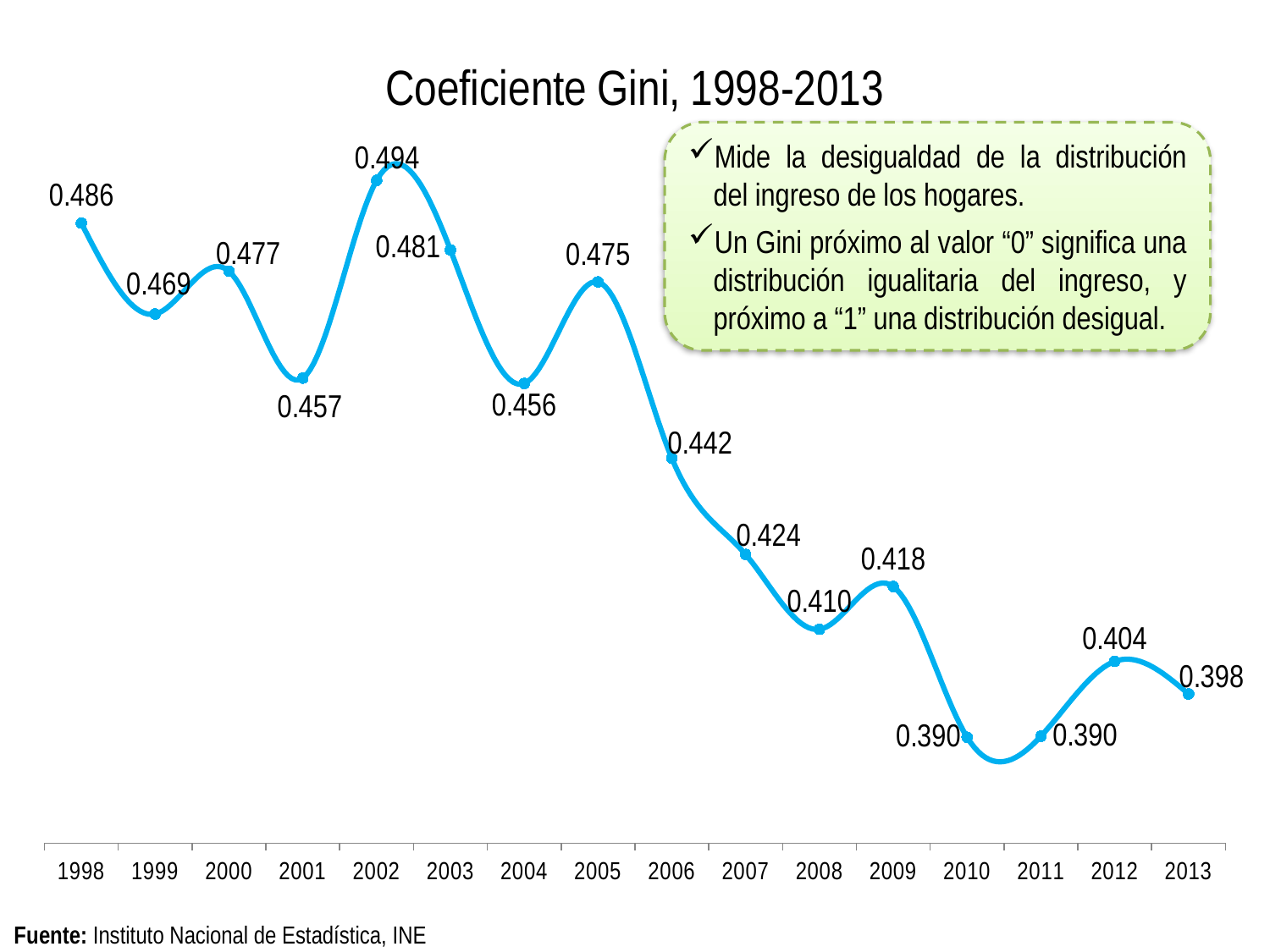
How many years are plotted on the chart? 16 What is the lowest Gini coefficient value shown on the chart? 0.390 What is the Gini coefficient value for 2006? 0.442 Which year has a higher Gini coefficient, 2005 or 2006? 2005 Overall, does the Gini coefficient rise or fall from 1998 to 2013? Fall What is the difference between the Gini coefficient in 2002 and in 2013? 0.096 Which year has a higher Gini coefficient, 2009 or 2008? 2009 What is the difference between the Gini coefficient in 1998 and in 2013? 0.088 What is the Gini coefficient value for 2013? 0.398 What kind of chart is shown on the slide? Line chart Which year has the highest Gini coefficient? 2002 What is the Gini coefficient value for 2002? 0.494